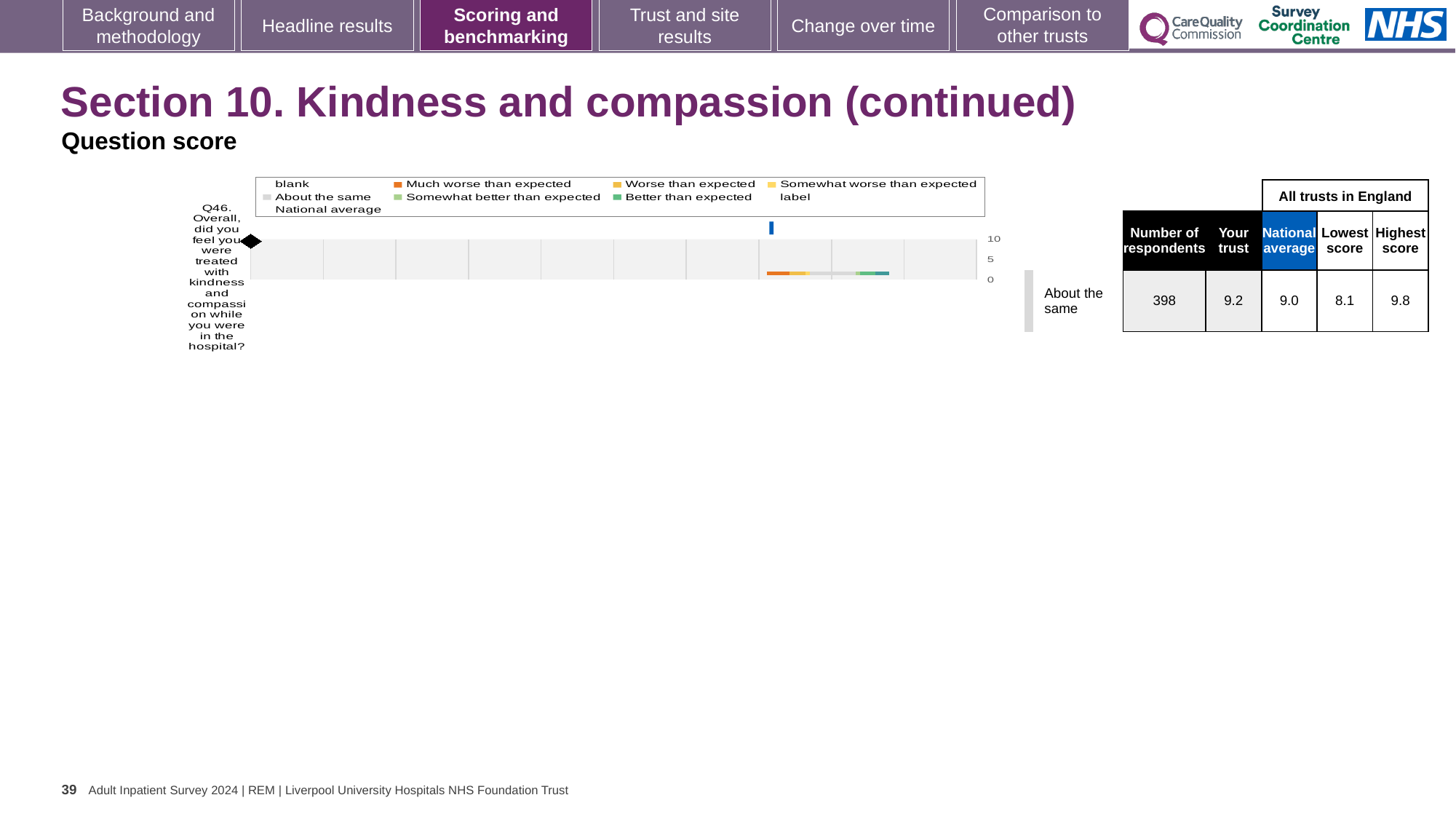
Which benchmarking category is the trust's Q46 result placed in? About the same What kind of chart is shown on the slide? bar chart What is the highest tick value shown on the chart's score axis? 10 What is the National average score for Q46? 9.0 What is the difference between the Your trust score and the National average for Q46? 0.2 Which survey question does the chart on this slide show the score for? Q46. Overall, did you feel you were treated with kindness and compassion while you were in the hospital? What is the score for Your trust on Q46? 9.2 How many respondents answered Q46 for this trust? 398 What is the difference between the Highest score and the Lowest score for Q46? 1.7 Which is larger for Q46: the Your trust score or the National average? Your trust What is the Lowest score among all trusts in England for Q46? 8.1 What is the Highest score among all trusts in England for Q46? 9.8